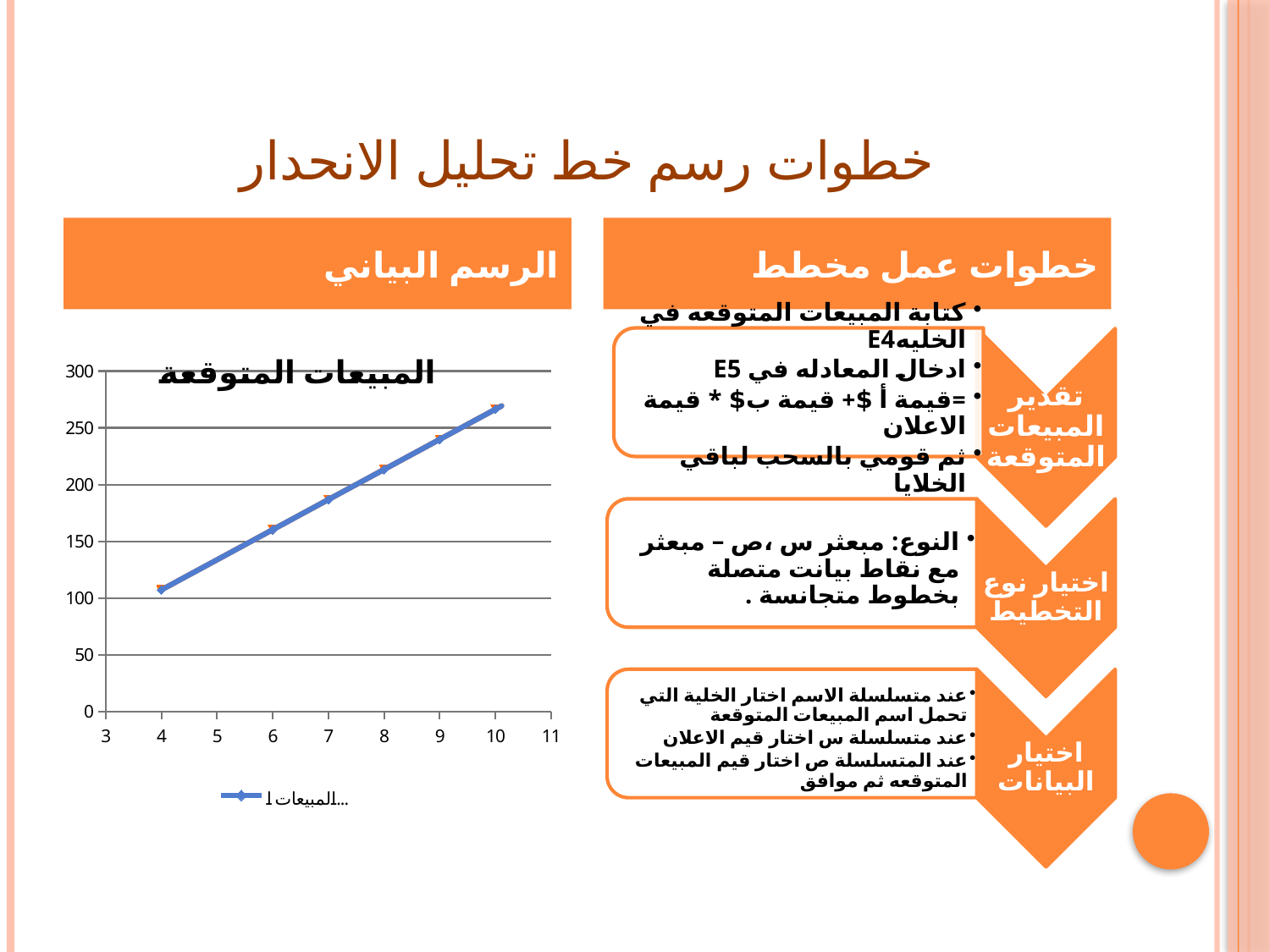
Is the value at x = 10 greater or less than 250? greater What is the title of the chart? المبيعات المتوقعة Do the plotted values rise or fall as the x-axis value increases? Rise How many series does the chart legend list? 1 Is the value at x = 8 greater or less than 200? greater Is the value at x = 4 greater or less than 150? less What is the highest value shown on the y-axis? 300 What kind of chart is shown on the slide? Scatter chart with a line Which has the larger value, the point at x = 4 or the point at x = 10? x = 10